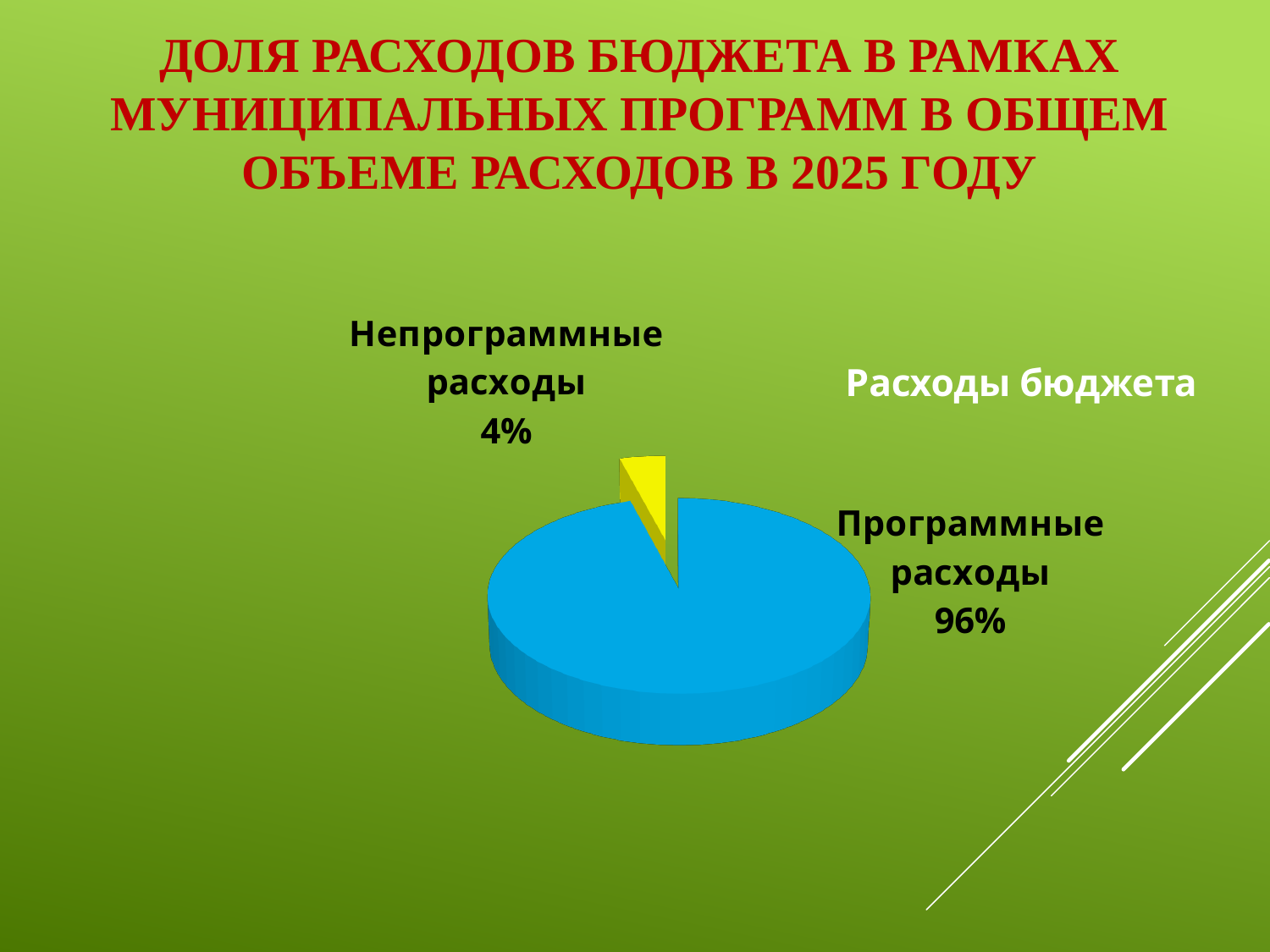
What is the difference in percentage points between Программные расходы and Непрограммные расходы? 92 Which is larger, Программные расходы or Непрограммные расходы? Программные расходы What share of the pie does Программные расходы represent? 96% What share of the pie does Непрограммные расходы represent? 4% How many slices does the pie chart have? 2 Which slice of the pie is the smallest? Непрограммные расходы Which slice of the pie is the largest? Программные расходы What kind of chart is shown on the slide? Pie chart What is the title of the chart? Расходы бюджета What colour is the slice for Непрограммные расходы? Yellow